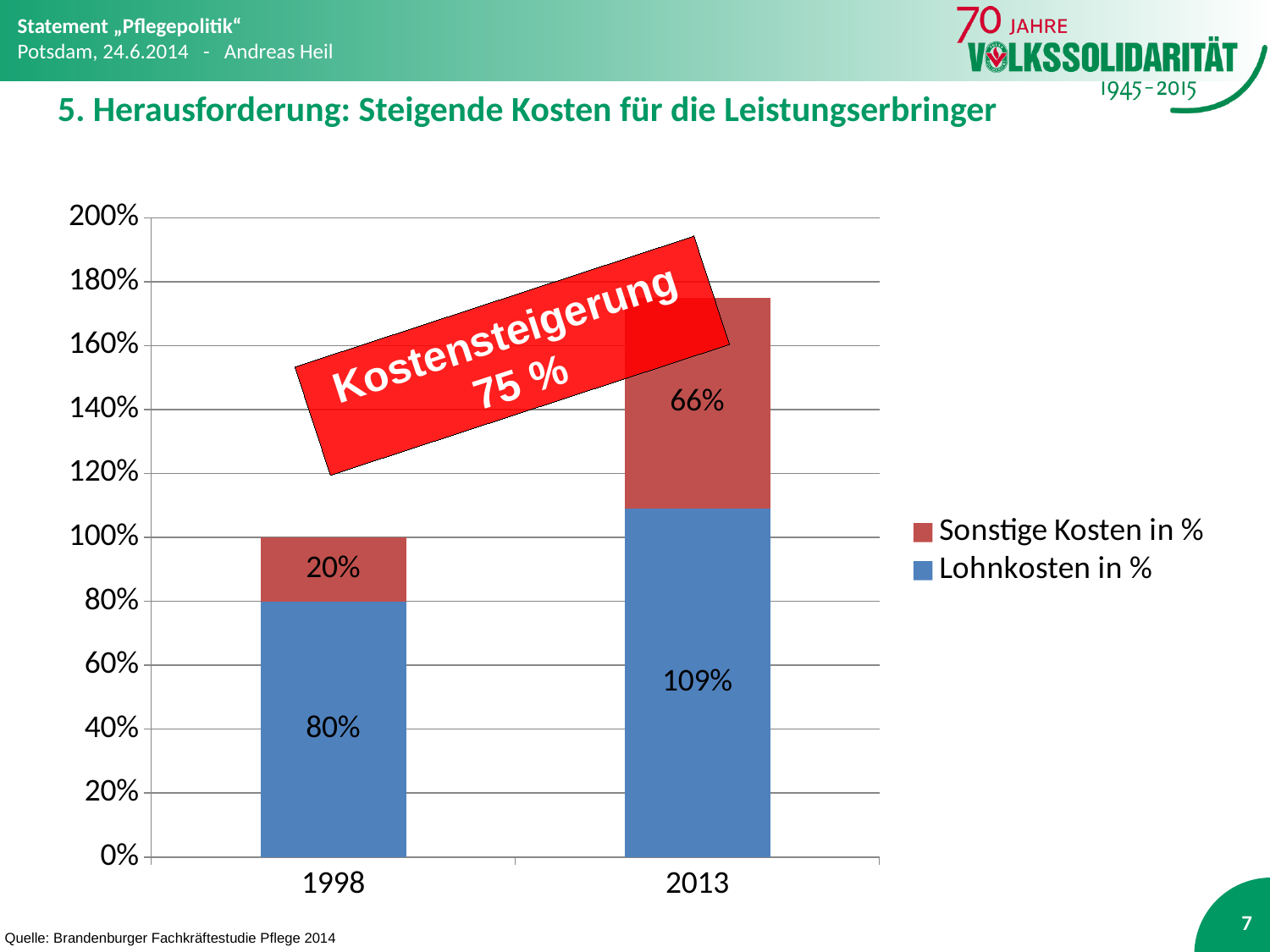
What is the difference between Lohnkosten in % for 2013 and for 1998? 29% What is the total of the stacked bar for 1998? 100% What kind of chart is shown on the slide? Stacked bar chart How many series does the legend list? 2 What is the total of the stacked bar for 2013? 175% How many categories are shown on the x axis? 2 What is the value of Sonstige Kosten in % for 2013? 66% Which colour represents Lohnkosten in % in the chart? Blue What is the value of Lohnkosten in % for 2013? 109% What is the value of Sonstige Kosten in % for 1998? 20% Which year has the higher value for Sonstige Kosten in %? 2013 What is the value of Lohnkosten in % for 1998? 80%